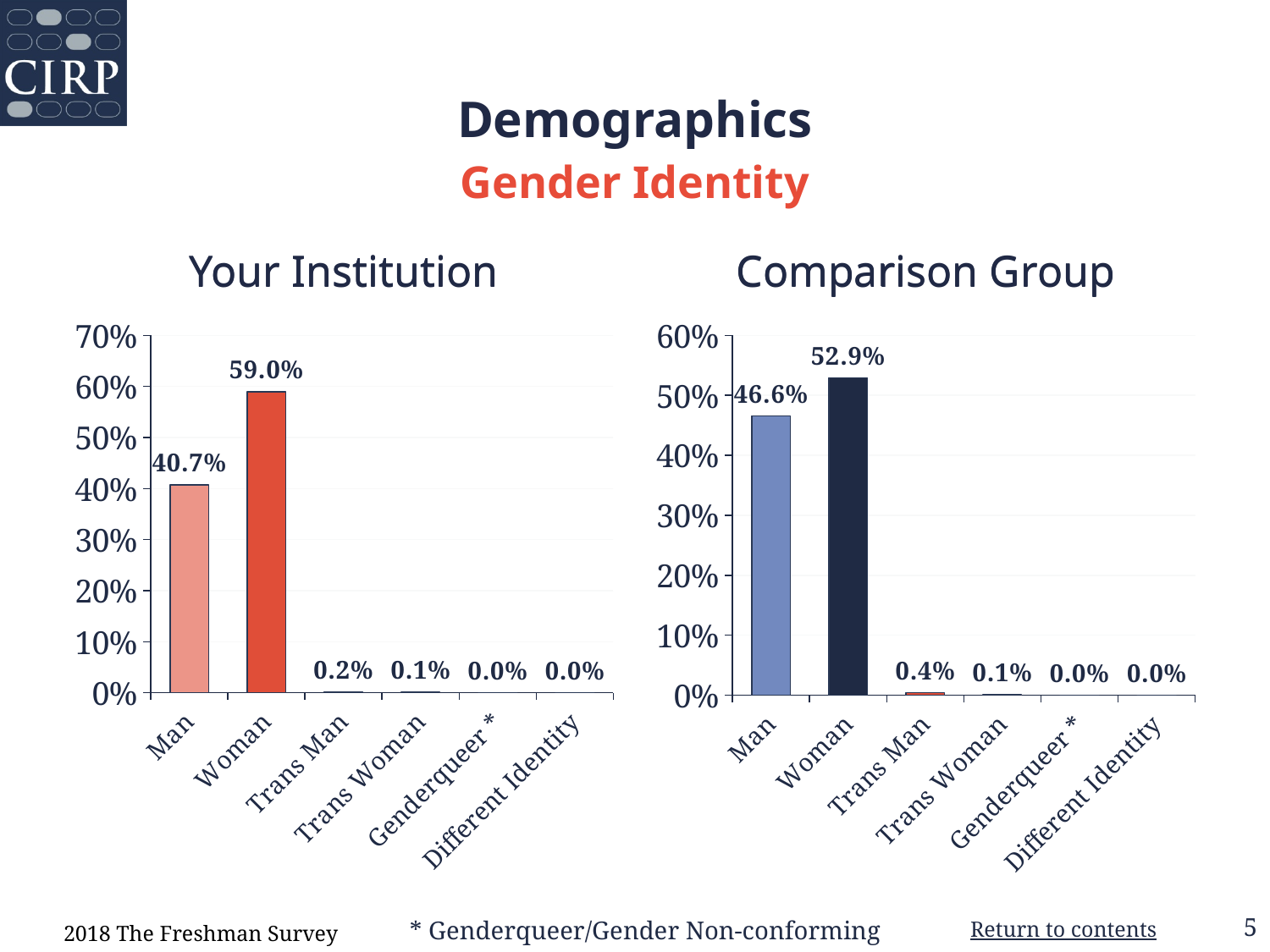
What kind of chart is the Comparison Group chart? Bar chart In the Your Institution chart, is the value for Man greater or less than 50%? less How many categories are shown on the x axis of the Your Institution chart? 6 In the Your Institution chart, what is the value for Trans Man? 0.2% Is the value for Man larger in the Your Institution chart or the Comparison Group chart? Comparison Group In the Comparison Group chart, what is the difference between the values for Woman and Man? 6.3% In the Comparison Group chart, which category has the highest value? Woman In the Comparison Group chart, what is the value for Trans Man? 0.4% In the Your Institution chart, which category has the highest value? Woman In the Your Institution chart, what is the value for Woman? 59.0% In the Comparison Group chart, what is the value for Man? 46.6% In the Your Institution chart, what is the difference between the values for Woman and Man? 18.3%